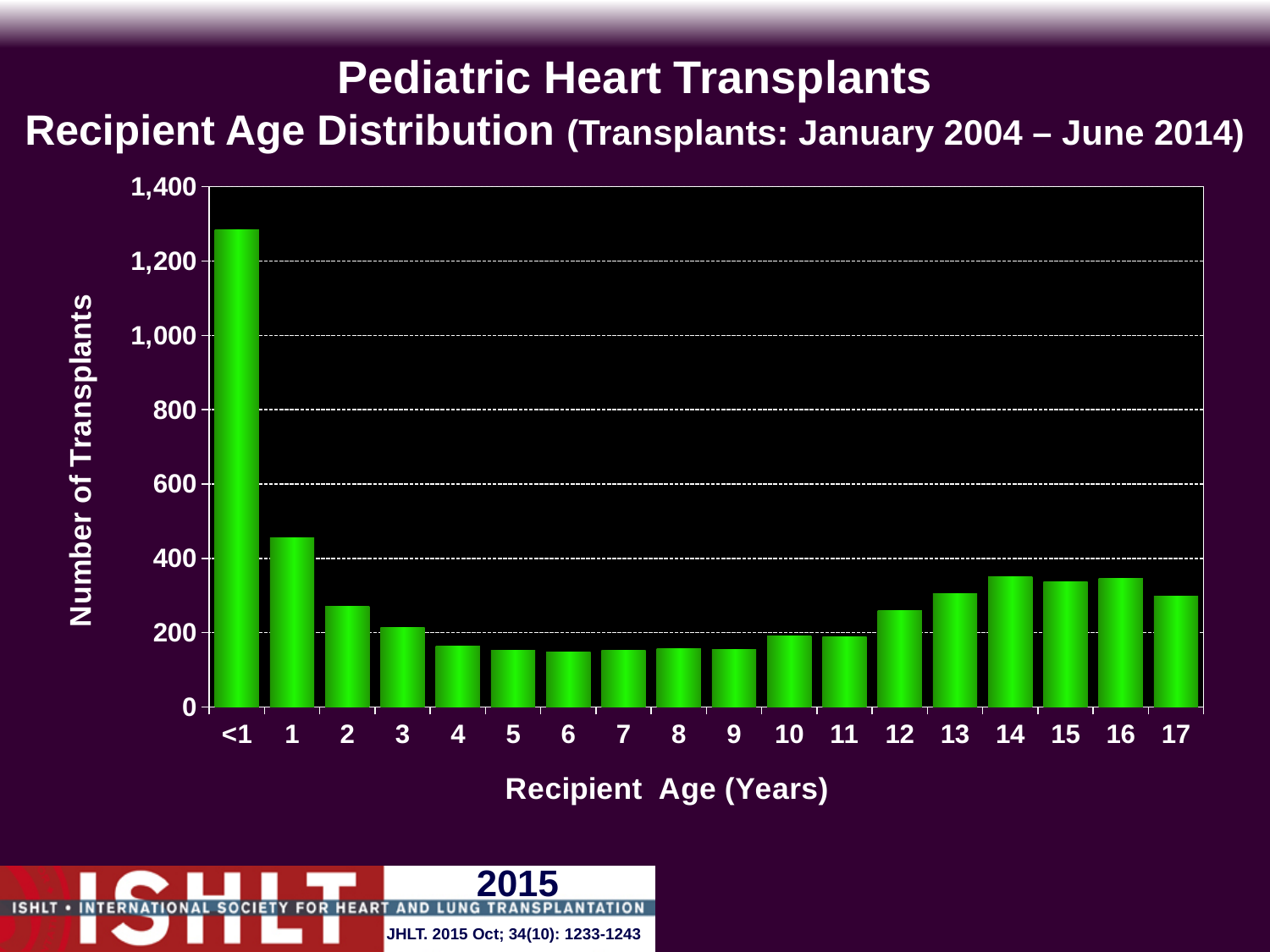
Which recipient age group has the highest number of transplants? <1 What is the title of the y axis? Number of Transplants Is the number of transplants for recipients aged 4 greater or less than 200? less Is the number of transplants for recipients aged 14 greater or less than 400? less Is the number of transplants for recipients aged 1 greater or less than 400? greater Which has more transplants: recipients aged 1 or recipients aged 2? 1 What kind of chart is shown on the slide? Bar chart Do the number of transplants rise or fall as recipient age goes from <1 to 6 years? fall Which has more transplants: recipients aged 14 or recipients aged 12? 14 How many recipient age categories are shown on the x axis? 18